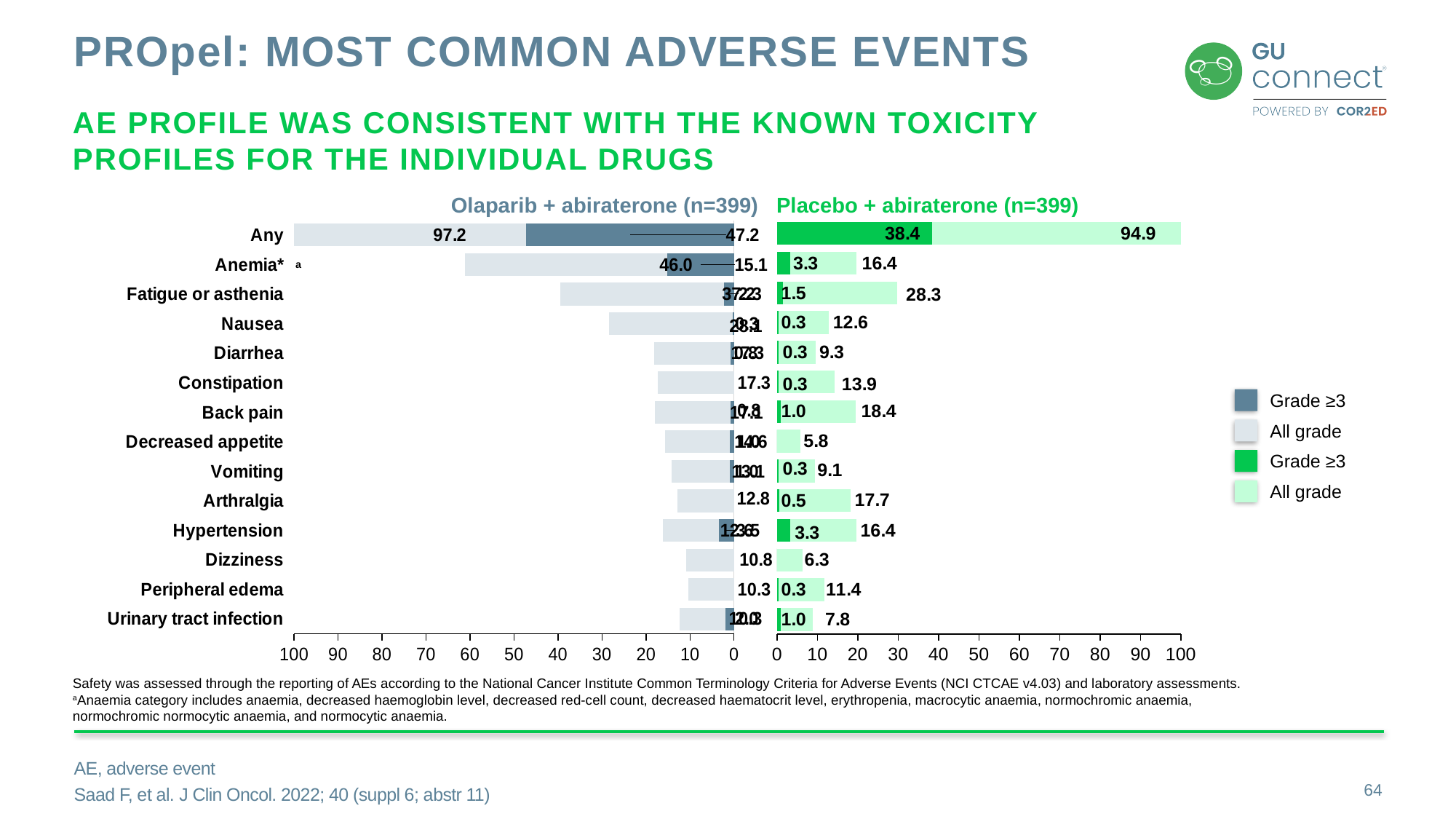
How many adverse event categories are listed on the chart? 14 In the Placebo + abiraterone panel, what is the Grade ≥3 value for Hypertension? 3.3 In the Placebo + abiraterone panel, which adverse event category has the lowest all-grade value? Decreased appetite How many entries does the legend list? 4 In the Olaparib + abiraterone panel, what is the Grade ≥3 value for Any adverse event? 47.2 In the Olaparib + abiraterone panel, what is the all-grade value for Anemia? 46.0 In the Placebo + abiraterone panel, what is the all-grade value for Any adverse event? 94.9 What type of chart is shown on the slide? Bar chart In the Olaparib + abiraterone panel, what is the all-grade value for Any adverse event? 97.2 Which is larger: the all-grade value for Back pain or for Arthralgia in the Placebo + abiraterone panel? Back pain What is the difference between the all-grade Anemia values in the Olaparib + abiraterone panel (46.0) and the Placebo + abiraterone panel (16.4)? 29.6 In the Placebo + abiraterone panel, what is the all-grade value for Fatigue or asthenia? 28.3